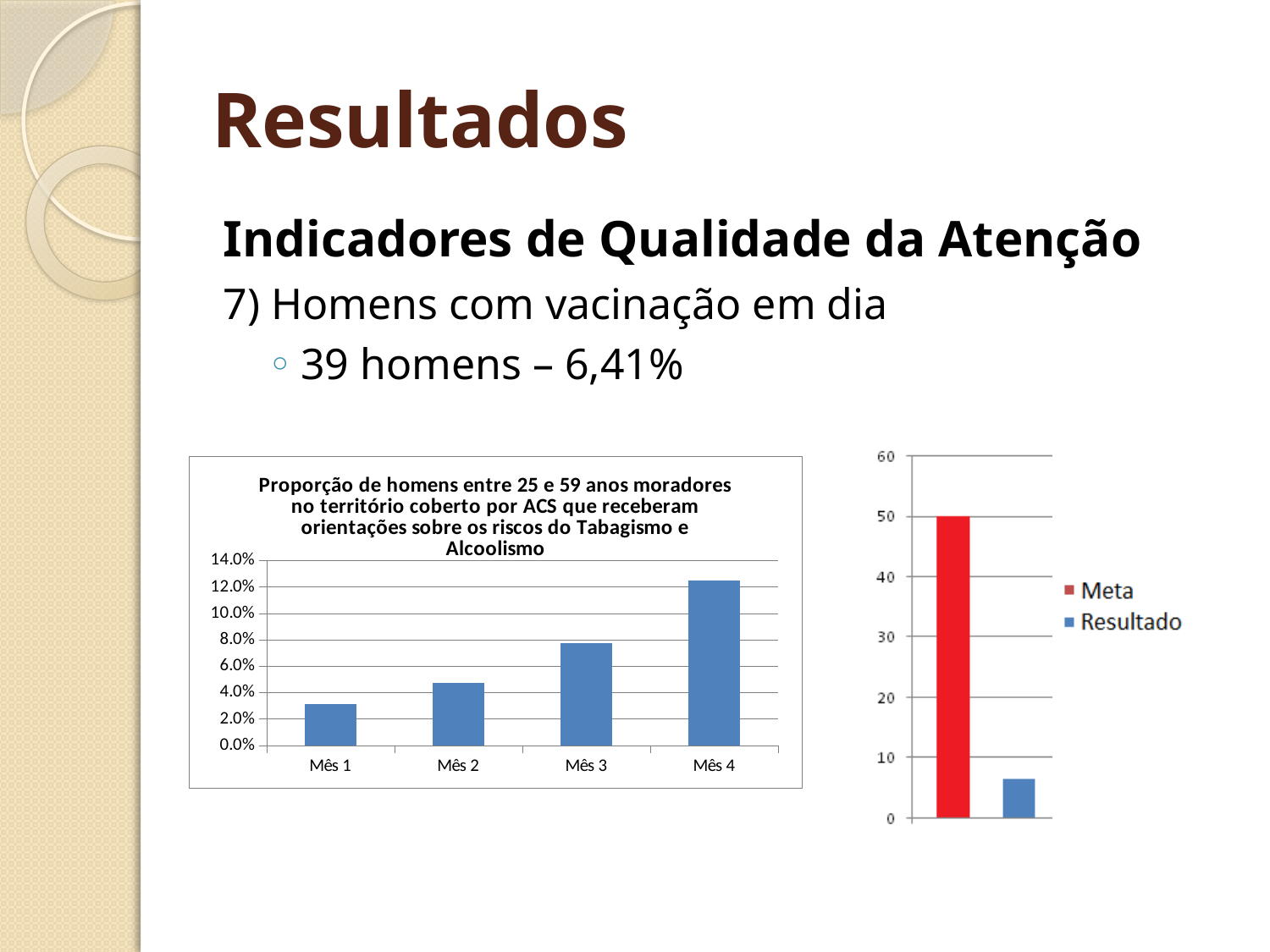
In the left chart, which month has the highest value? Mês 4 In the left chart, do the values rise or fall from Mês 1 to Mês 4? rise How many series does the legend of the right chart list? 2 How many categories are shown on the x axis of the left chart? 4 In the right chart, is the value for Resultado greater or less than 10? less In the right chart, what colour is the Meta bar? red What kind of chart is the left chart on the slide? bar chart In the left chart, which month has the lowest value? Mês 1 In the left chart, is the value for Mês 2 greater or less than 6.0%? less In the left chart, which is larger, the value for Mês 3 or the value for Mês 2? Mês 3 In the right chart, what is the value of Meta? 50 In the left chart, is the value for Mês 4 greater or less than 12.0%? greater